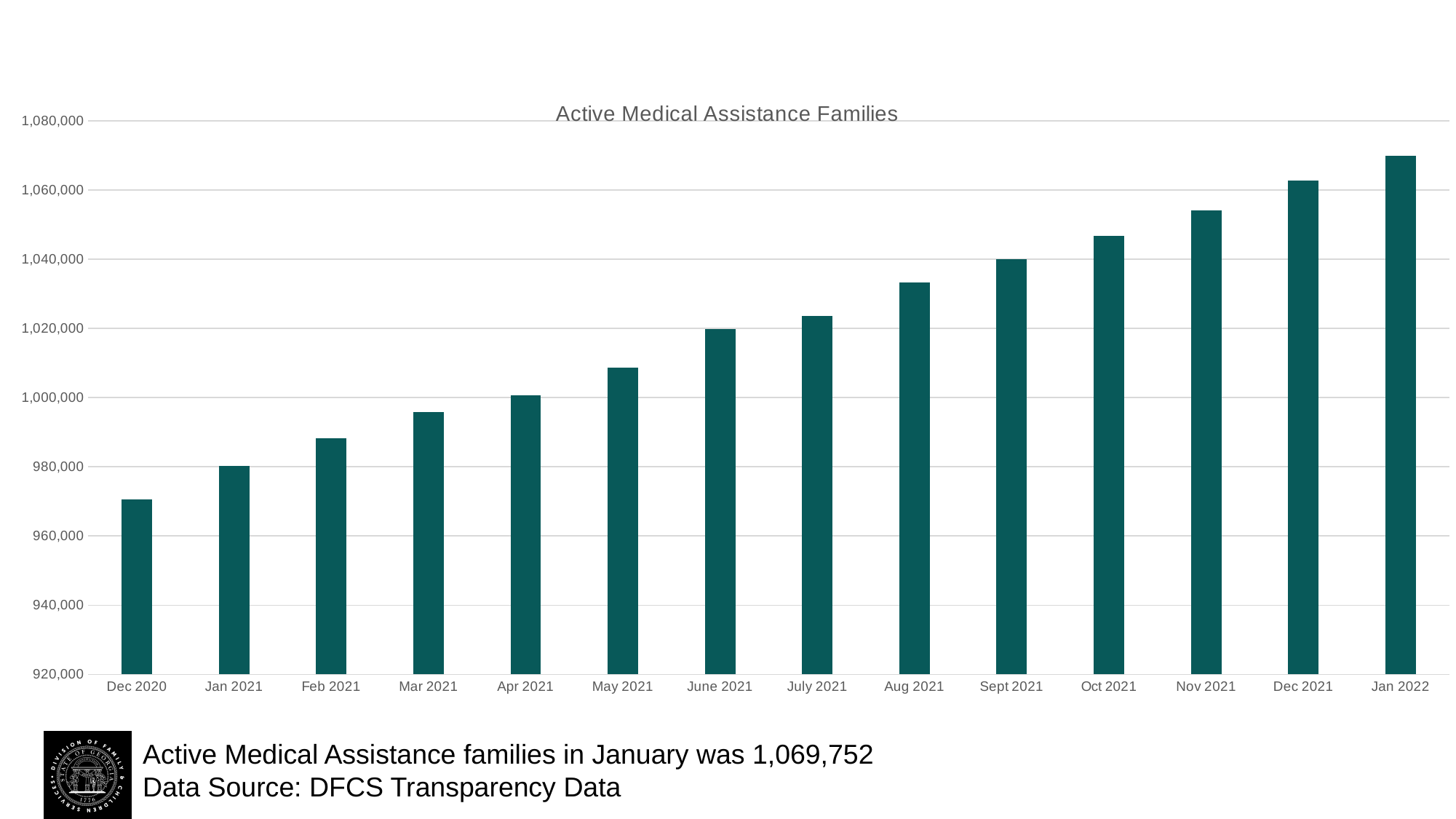
Is the value for Dec 2020 greater or less than 980,000? less How many months are plotted on the chart? 14 What type of chart is shown on the slide? Bar chart Which is larger, the value for Mar 2021 or the value for Oct 2021? Oct 2021 Do the values rise or fall from Dec 2020 to Jan 2022? Rise Is the value for May 2021 greater or less than 1,000,000? greater Which month has the lowest number of active Medical Assistance families? Dec 2020 What is the title of the chart? Active Medical Assistance Families Is the value for Aug 2021 greater or less than 1,040,000? less Which month has the highest number of active Medical Assistance families? Jan 2022 What was the number of active Medical Assistance families in Jan 2022? 1,069,752